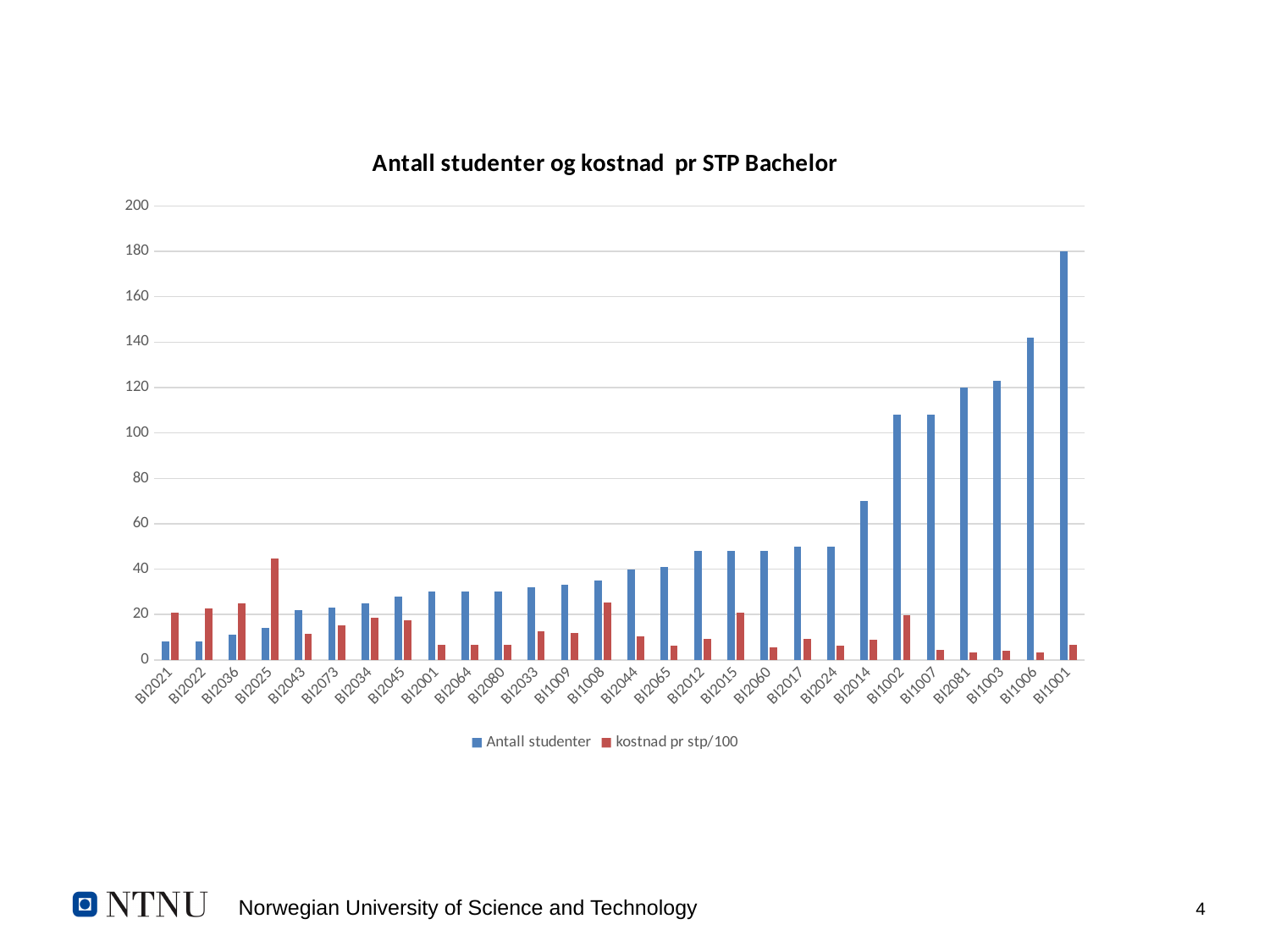
Which has the larger Antall studenter value, BI1006 or BI1003? BI1006 Is the Antall studenter value for BI2014 greater or less than 60? greater What kind of chart is shown on the slide? bar chart How many series does the legend list? 2 For BI2021, which series has the larger value, Antall studenter or kostnad pr stp/100? kostnad pr stp/100 Which course has the highest value for Antall studenter? BI1001 Which course has the highest value for kostnad pr stp/100? BI2025 Is the kostnad pr stp/100 value for BI2025 greater or less than 40? greater Do the Antall studenter values generally rise or fall from left to right along the x axis? rise How many course categories are shown on the x axis? 28 Is the Antall studenter value for BI1001 greater or less than 160? greater What is the title of the chart? Antall studenter og kostnad pr STP Bachelor